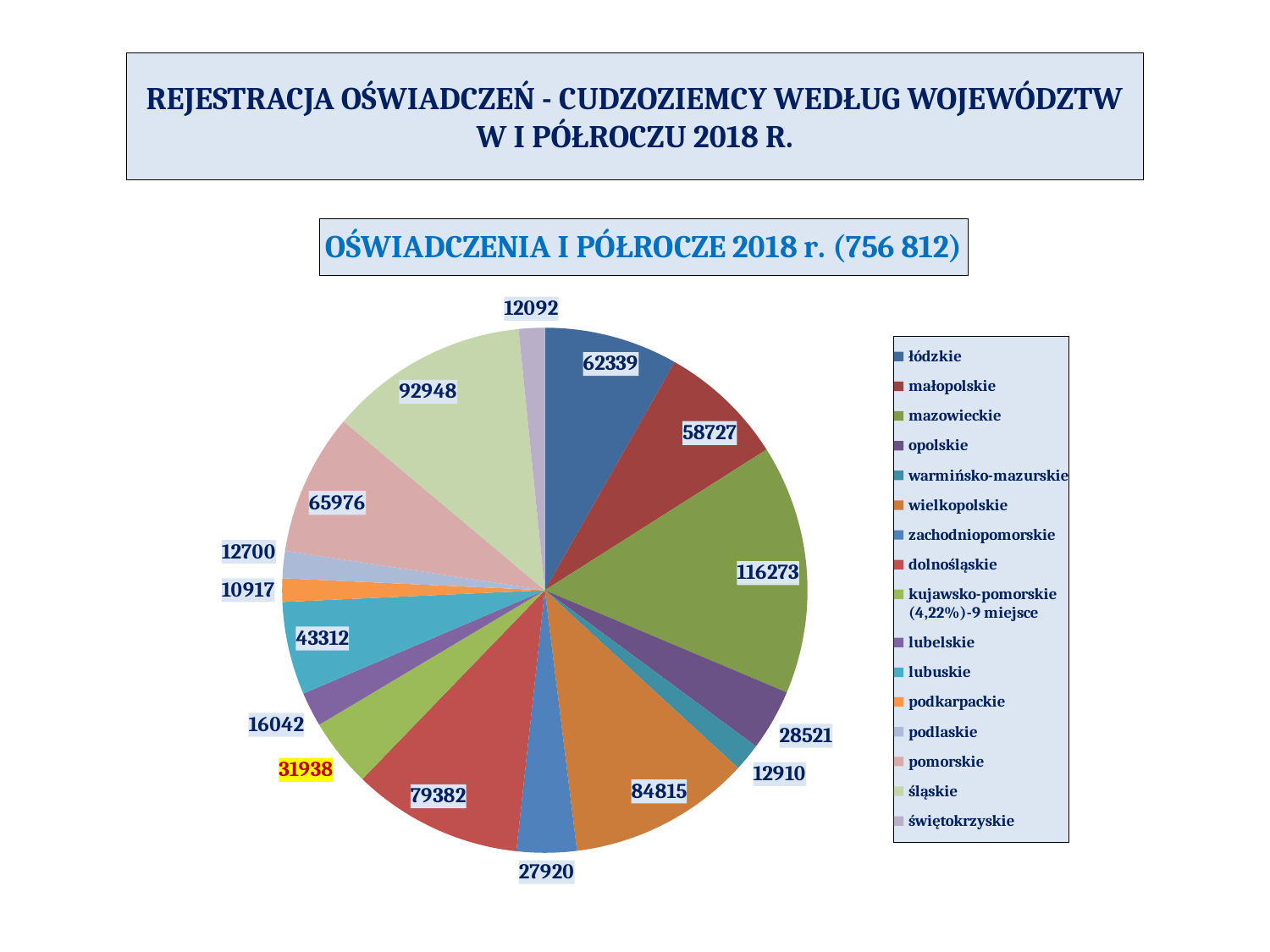
What is the difference between the values for mazowieckie and śląskie? 23325 What share of the pie does kujawsko-pomorskie have, according to the legend? 4,22% Which voivodeship has the largest slice of the pie? mazowieckie What kind of chart is shown on the slide? pie chart What value is shown for wielkopolskie? 84815 Which voivodeship has the smallest slice of the pie? podkarpackie What value is shown for lubuskie? 43312 How many voivodeships are listed in the legend? 16 Which is larger, the value for łódzkie or the value for małopolskie? łódzkie What value is shown for śląskie? 92948 What value is shown for mazowieckie? 116273 What total is given in the chart title for the first half of 2018? 756 812